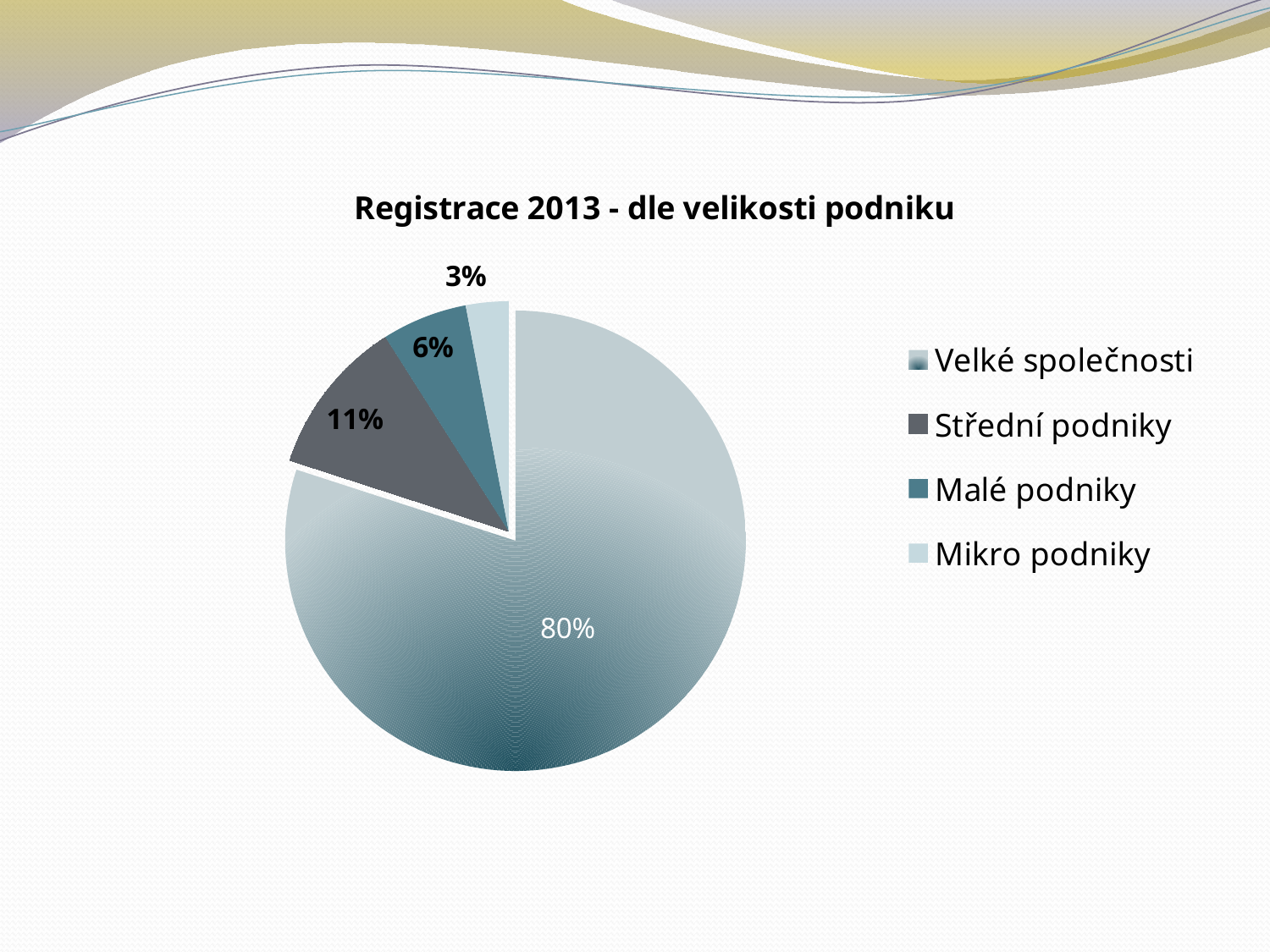
Which category has the smallest slice of the pie? Mikro podniky How many categories does the pie chart show? 4 How many entries does the legend list? 4 What share of the pie does Mikro podniky have? 3% What share of the pie does Střední podniky have? 11% What kind of chart is shown on the slide? pie chart Which category has the largest slice of the pie? Velké společnosti Which is larger, the share of Malé podniky or the share of Mikro podniky? Malé podniky What share of the pie does Malé podniky have? 6% What is the title of the chart? Registrace 2013 - dle velikosti podniku What is the difference between the shares of Střední podniky and Malé podniky? 5%